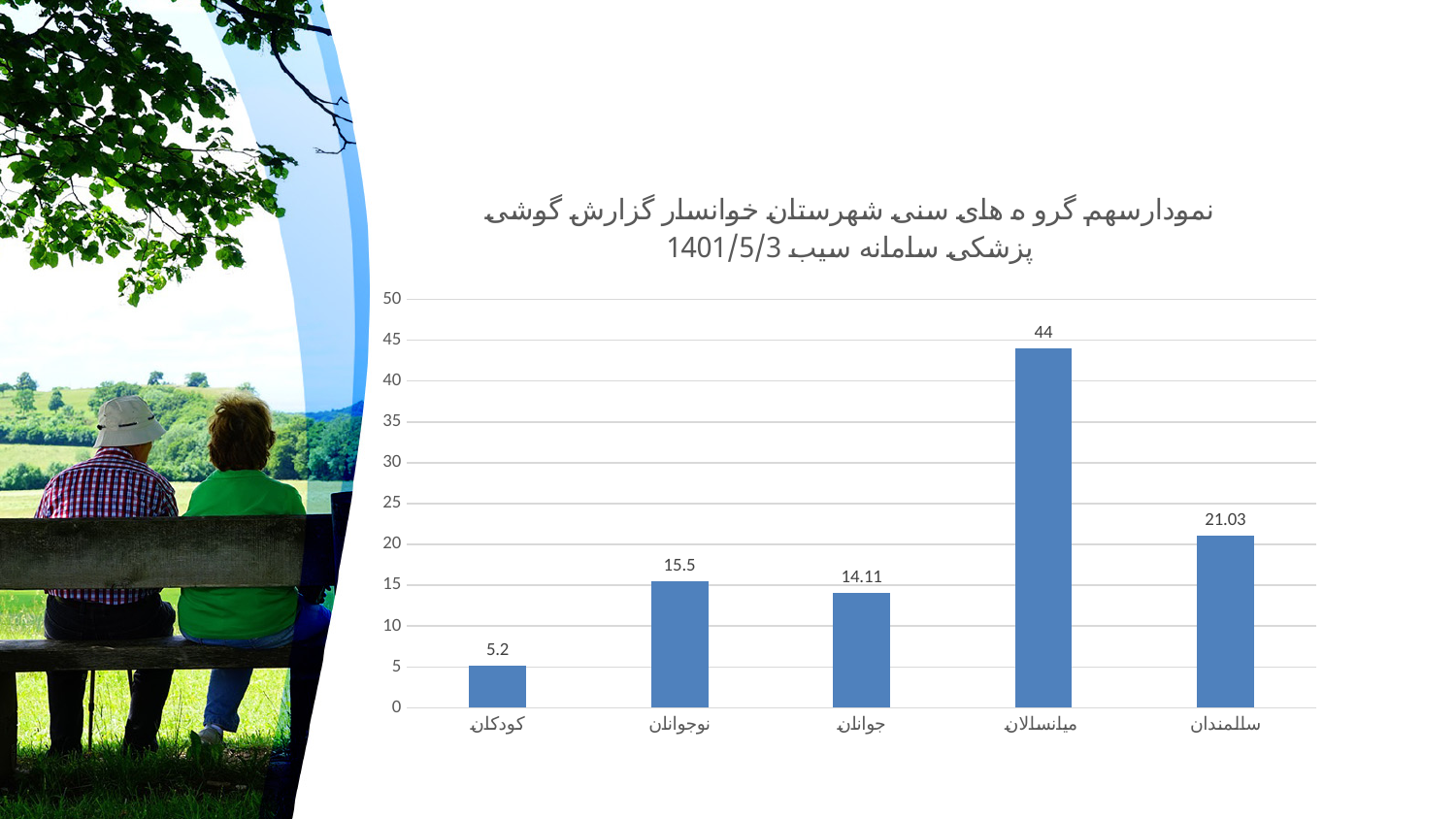
Which category has the lowest value? کودکان What is the value for سالمندان? 21.03 Which category has the highest value? میانسالان Is the value for سالمندان greater or less than 20? greater What is the value for میانسالان? 44 Which is larger, the value for نوجوانان or the value for جوانان? نوجوانان What is the value for نوجوانان? 15.5 What is the value for کودکان? 5.2 What is the difference between the values for میانسالان and سالمندان? 22.97 What kind of chart is shown on the slide? bar chart How many categories are shown on the x axis? 5 What is the value for جوانان? 14.11